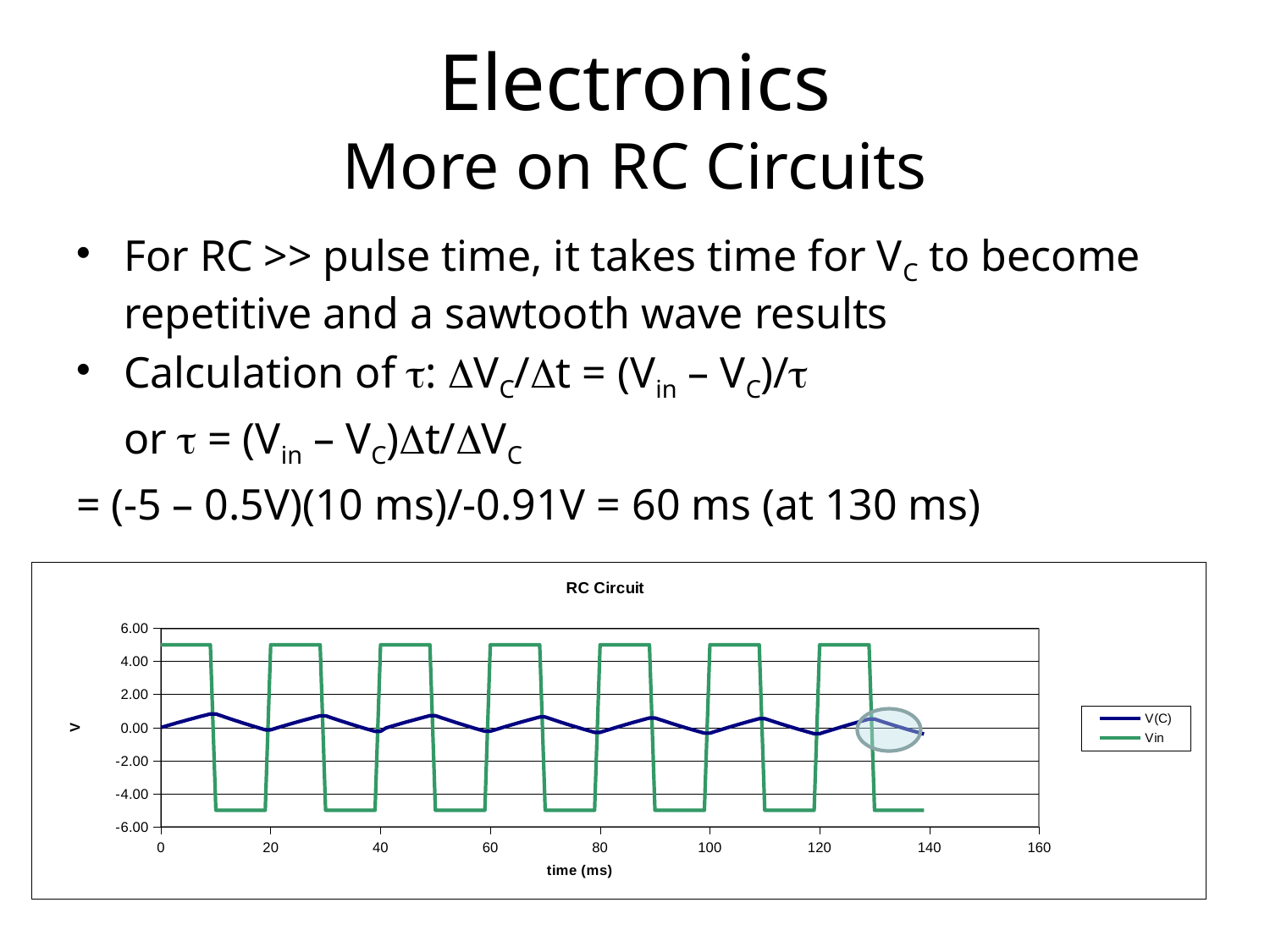
In the RC Circuit chart, is the value of V(C) at 10 ms greater or less than 0.00? greater In the RC Circuit chart, is the value of Vin at 15 ms greater or less than -4.00? less What are the two series named in the legend of the RC Circuit chart? V(C) and Vin In the RC Circuit chart, is the value of V(C) at 20 ms greater or less than 2.00? less How many series does the legend of the RC Circuit chart list? 2 What kind of chart is the RC Circuit chart? line chart What is the title of the chart on the slide? RC Circuit In the RC Circuit chart, which series has the higher value at 5 ms, V(C) or Vin? Vin In the RC Circuit chart, which series has the higher value at 15 ms, V(C) or Vin? V(C)